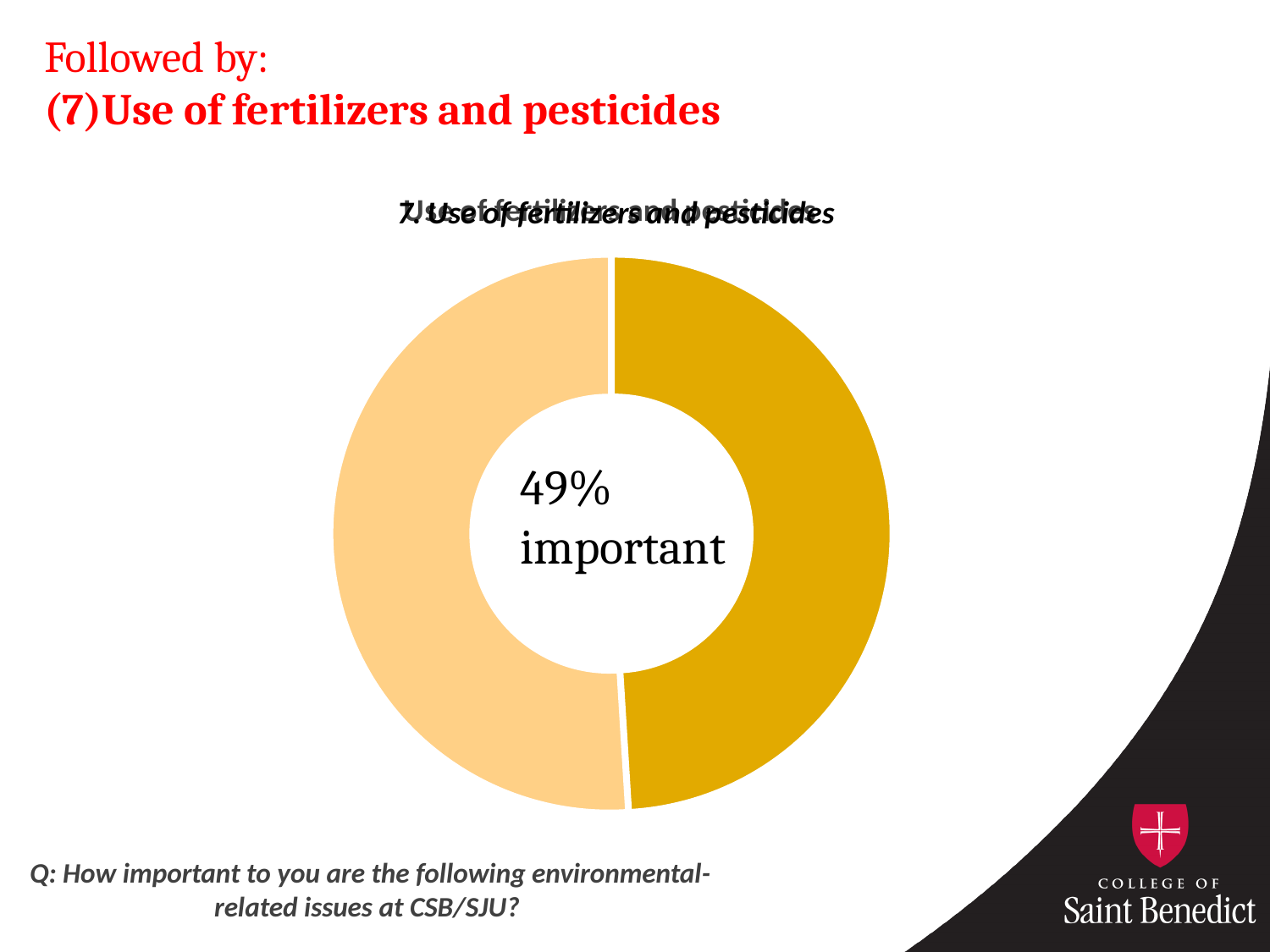
What share of respondents rated use of fertilizers and pesticides as important, according to the chart? 49% Is the share labelled 'important' in the chart greater or less than 50%? less What word appears below the 49% figure in the centre of the chart? important What percentage is printed in the centre of the doughnut chart? 49% What kind of chart is shown on the slide? doughnut chart What is the title of the chart? Use of fertilizers and pesticides How many slices does the doughnut chart have? 2